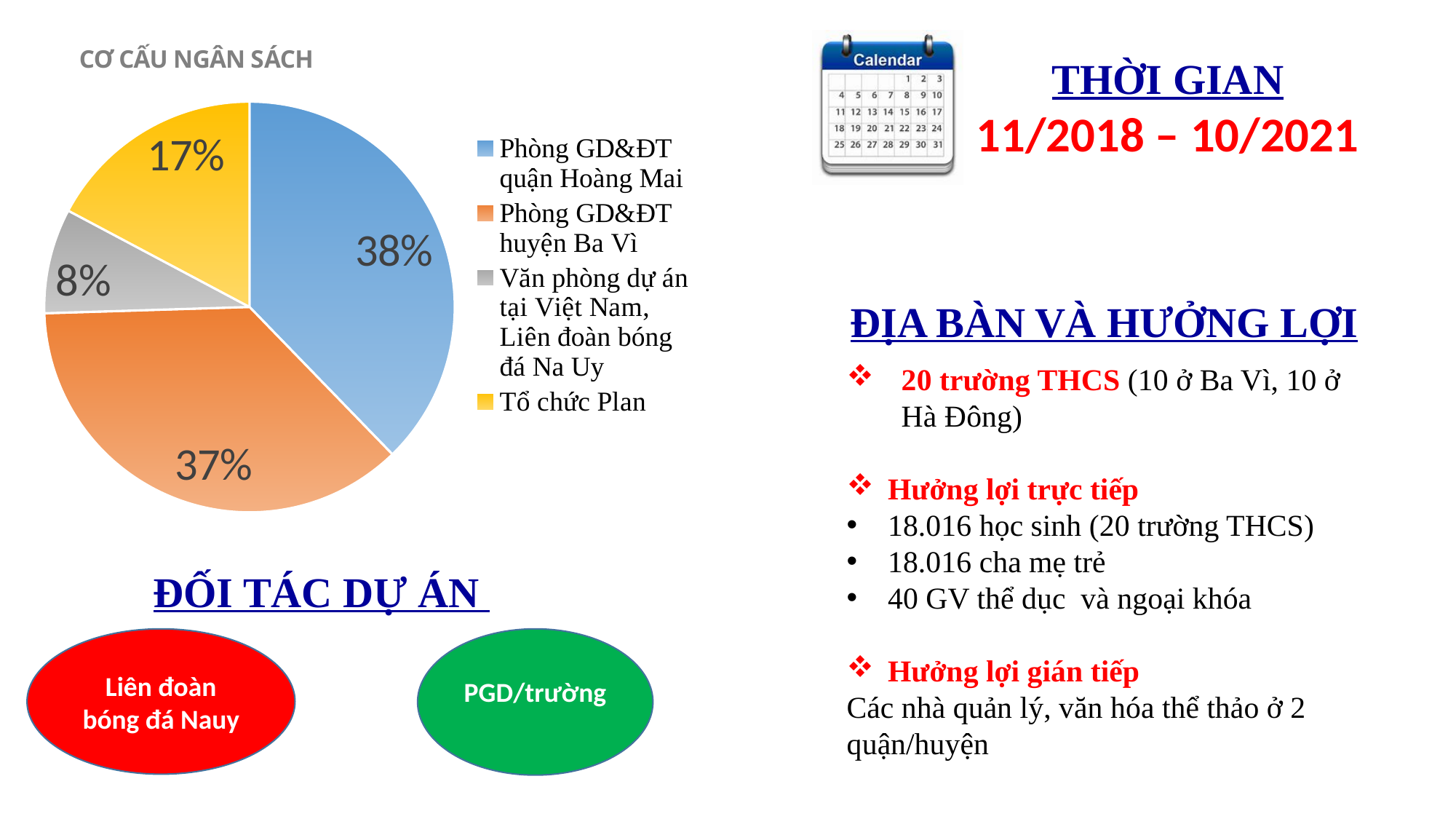
Which category has the smallest share in the pie chart? Văn phòng dự án tại Việt Nam, Liên đoàn bóng đá Na Uy How many slices does the pie chart have? 4 What colour is the slice for Tổ chức Plan in the pie chart? Yellow What is the difference in percentage points between the share of Tổ chức Plan and the share of Văn phòng dự án tại Việt Nam, Liên đoàn bóng đá Na Uy? 9 percentage points Which category has the largest share in the pie chart? Phòng GD&ĐT quận Hoàng Mai Which has a larger share in the pie chart: Tổ chức Plan or Văn phòng dự án tại Việt Nam, Liên đoàn bóng đá Na Uy? Tổ chức Plan What share of the budget does Tổ chức Plan account for in the pie chart? 17% What kind of chart is shown under the title "CƠ CẤU NGÂN SÁCH"? Pie chart What share of the budget does Văn phòng dự án tại Việt Nam, Liên đoàn bóng đá Na Uy account for in the pie chart? 8% What is the title of the pie chart? CƠ CẤU NGÂN SÁCH What share of the budget does Phòng GD&ĐT huyện Ba Vì account for in the pie chart? 37% What share of the budget does Phòng GD&ĐT quận Hoàng Mai account for in the pie chart? 38%